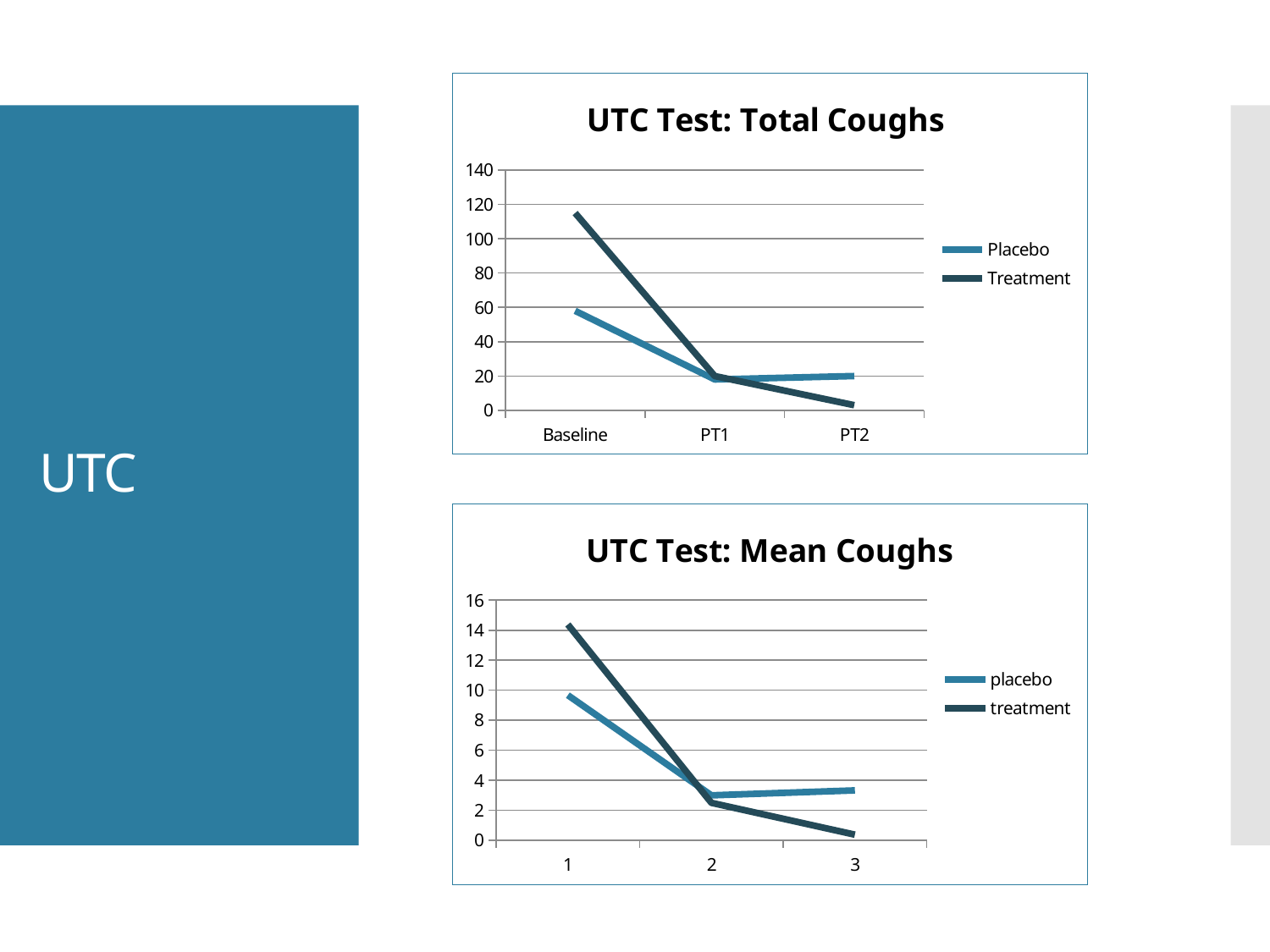
In the 'UTC Test: Mean Coughs' chart, how many series does the legend list? 2 In the 'UTC Test: Total Coughs' chart, is the Placebo value at Baseline greater or less than 80? less In the 'UTC Test: Total Coughs' chart, what kind of chart is shown? Line chart In the 'UTC Test: Total Coughs' chart, how many series does the legend list? 2 In the 'UTC Test: Total Coughs' chart, which series has the higher value at Baseline? Treatment In the 'UTC Test: Total Coughs' chart, how many categories are on the x axis? 3 In the 'UTC Test: Total Coughs' chart, which series has the higher value at PT2? Placebo In the 'UTC Test: Mean Coughs' chart, which series has the lower value at 3? treatment In the 'UTC Test: Total Coughs' chart, at which category is the Treatment series highest? Baseline In the 'UTC Test: Total Coughs' chart, does the Treatment series rise or fall from Baseline to PT2? Fall In the 'UTC Test: Total Coughs' chart, is the Treatment value at Baseline greater or less than 100? greater In the 'UTC Test: Mean Coughs' chart, is the treatment value at 1 greater or less than 12? greater